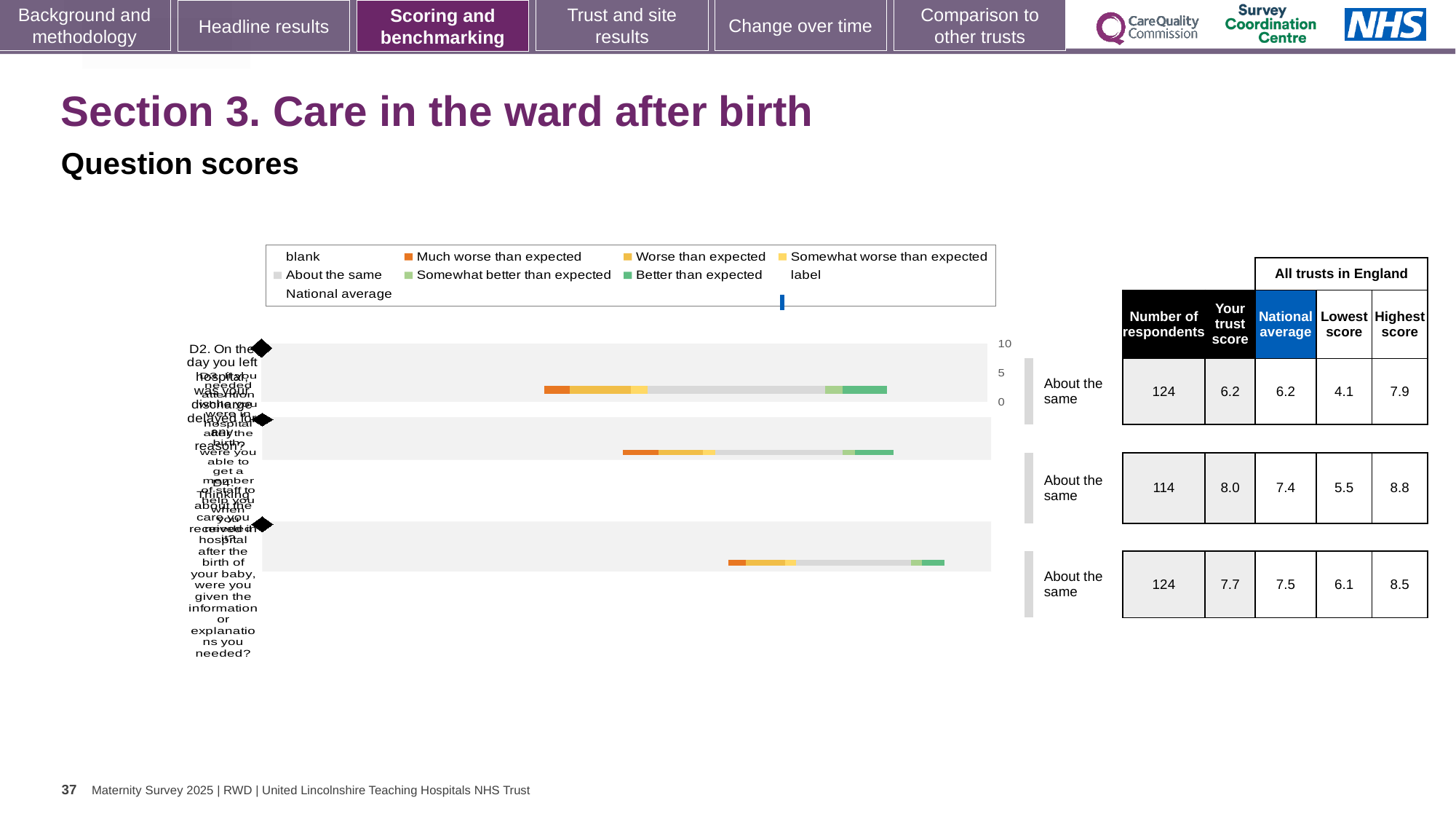
For the bottom question, which is larger: the trust score or the national average? trust score How many questions (bars) are plotted in the chart? 3 Which question (top, middle or bottom) has the highest 'Your trust score'? middle What is the 'Your trust score' for the top question in the chart? 6.2 What benchmark category is shown for all three questions in the chart? About the same What is the highest score across all trusts in England for the bottom question in the chart? 8.5 Which colour in the legend represents 'Better than expected'? green What kind of chart is shown on the slide? bar chart Which colour in the legend represents 'Much worse than expected'? orange What is the lowest score across all trusts in England for the top question in the chart? 4.1 What is the difference between the trust score and the national average for the middle question? 0.6 What is the number of respondents for the middle question in the chart? 114